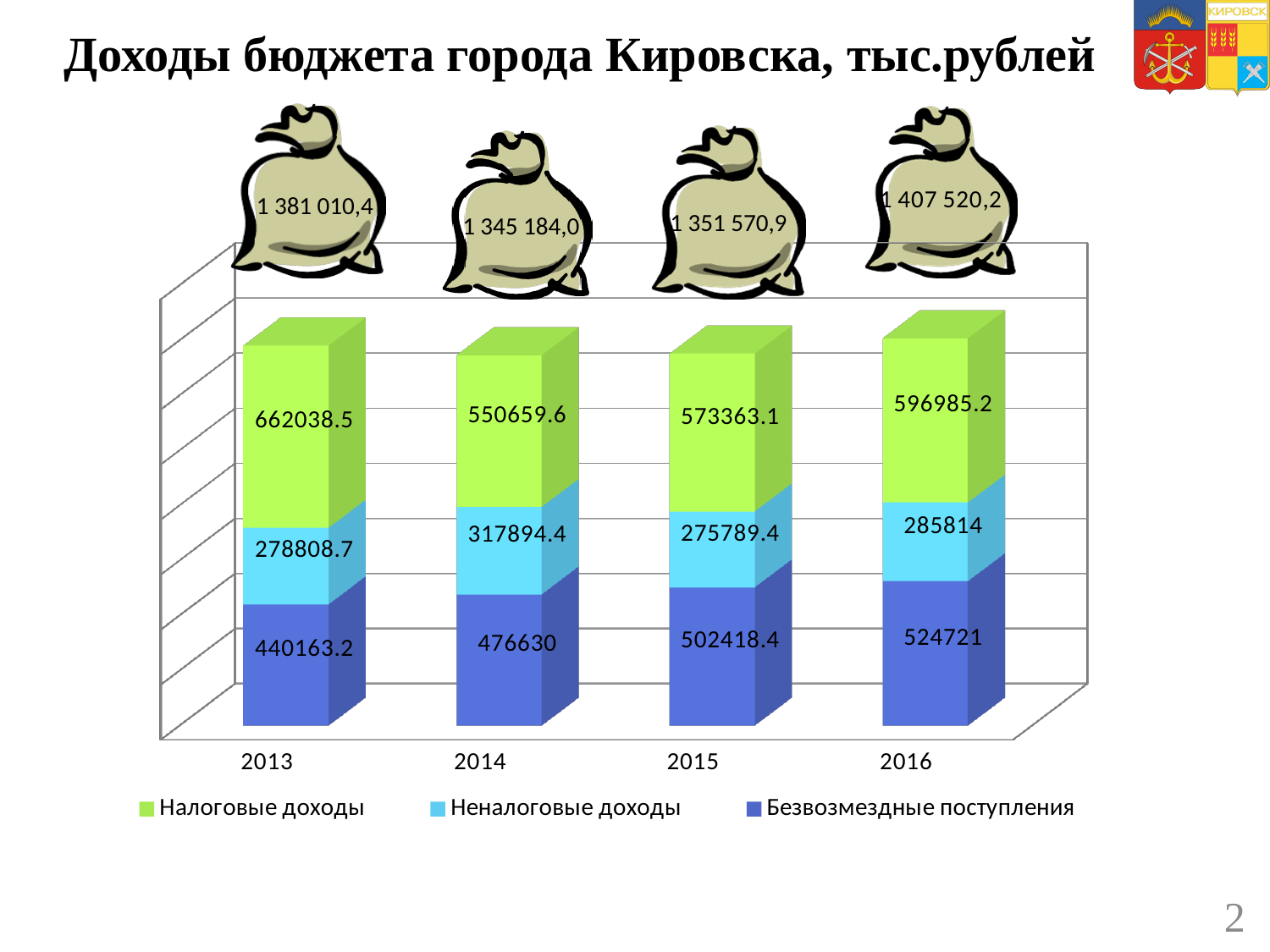
What type of chart is shown on the slide? stacked bar chart What is the difference between Безвозмездные поступления in 2016 and in 2013? 84557.8 What is the value of Безвозмездные поступления for 2016? 524721 Which is larger: Налоговые доходы in 2015 or in 2016? 2016 In which year is Безвозмездные поступления the lowest? 2013 What is the value of Неналоговые доходы for 2014? 317894.4 How many years are shown on the x axis? 4 In which year is Налоговые доходы the highest? 2013 What is the total budget income shown for 2016? 1 407 520,2 Do the values of Безвозмездные поступления rise or fall from 2013 to 2016? rise What is the value of Налоговые доходы for 2013? 662038.5 How many series does the legend list? 3